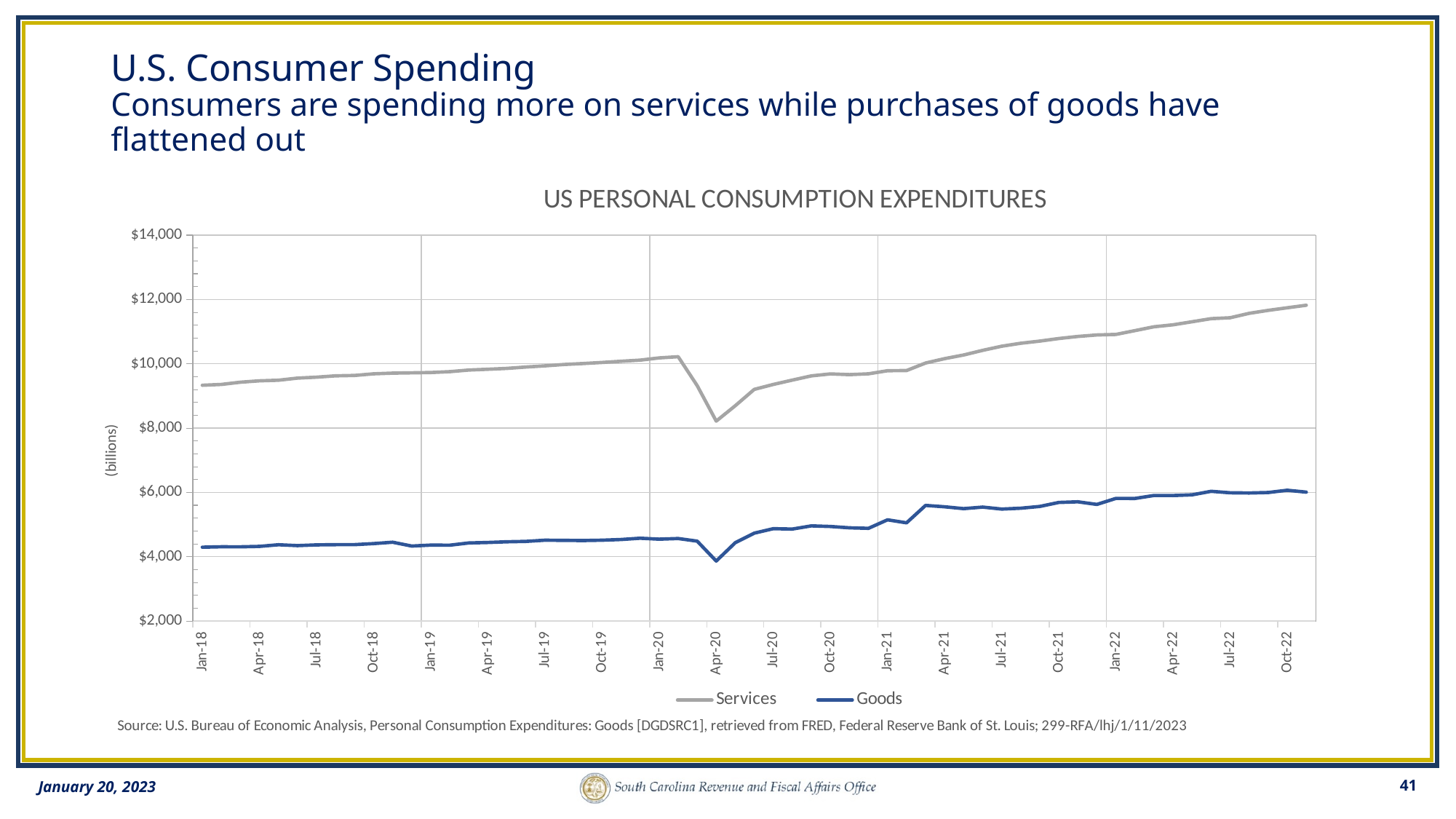
What kind of chart is shown on the slide? Line chart Is the value for Services in Jan-18 greater or less than $8,000? greater Is the value for Services in Jan-18 greater or less than $10,000? less Does the Services line generally rise or fall from Jan-18 to Oct-22? Rise How many series does the legend list? 2 Around which x-axis label does the Services line reach its lowest point? Apr-20 Is the value for Goods in Jan-22 greater or less than $6,000? less Which series is drawn in blue? Goods Which series has the higher value in Oct-22, Services or Goods? Services What is the title of the chart? US PERSONAL CONSUMPTION EXPENDITURES